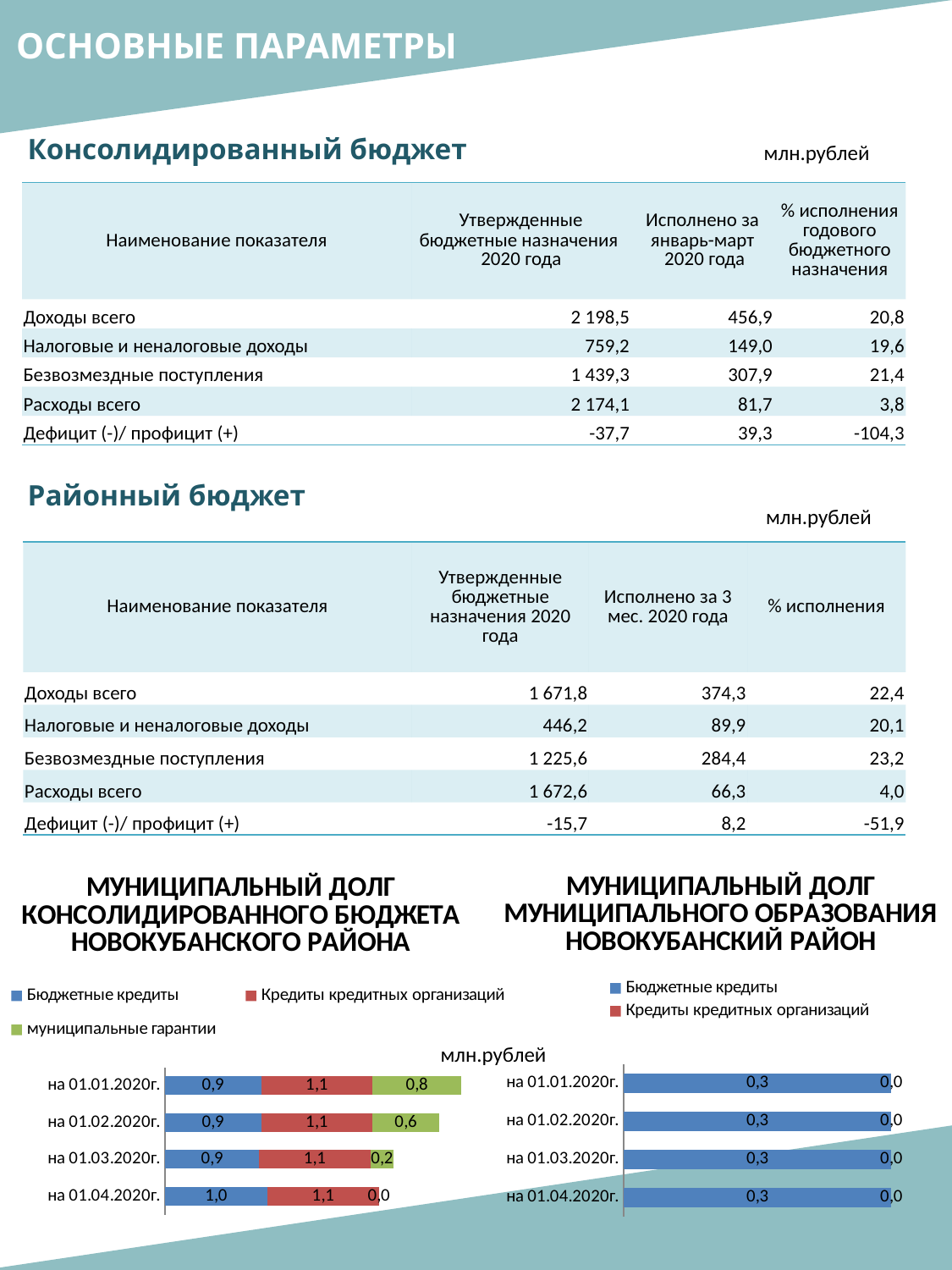
In the chart titled 'МУНИЦИПАЛЬНЫЙ ДОЛГ КОНСОЛИДИРОВАННОГО БЮДЖЕТА НОВОКУБАНСКОГО РАЙОНА', what is the total of the stacked bar for 01.01.2020? 2,8 In the chart titled 'МУНИЦИПАЛЬНЫЙ ДОЛГ КОНСОЛИДИРОВАННОГО БЮДЖЕТА НОВОКУБАНСКОГО РАЙОНА', what is the value of 'Кредиты кредитных организаций' on 01.03.2020? 1,1 How many series does the legend list in the chart titled 'МУНИЦИПАЛЬНЫЙ ДОЛГ КОНСОЛИДИРОВАННОГО БЮДЖЕТА НОВОКУБАНСКОГО РАЙОНА'? 3 In the chart titled 'МУНИЦИПАЛЬНЫЙ ДОЛГ КОНСОЛИДИРОВАННОГО БЮДЖЕТА НОВОКУБАНСКОГО РАЙОНА', what is the value of 'муниципальные гарантии' on 01.01.2020? 0,8 In the chart titled 'МУНИЦИПАЛЬНЫЙ ДОЛГ КОНСОЛИДИРОВАННОГО БЮДЖЕТА НОВОКУБАНСКОГО РАЙОНА', does the value of 'муниципальные гарантии' rise or fall from 01.01.2020 to 01.04.2020? fall In the chart titled 'МУНИЦИПАЛЬНЫЙ ДОЛГ КОНСОЛИДИРОВАННОГО БЮДЖЕТА НОВОКУБАНСКОГО РАЙОНА', what is the difference between 'муниципальные гарантии' on 01.01.2020 and on 01.03.2020? 0,6 In the chart titled 'МУНИЦИПАЛЬНЫЙ ДОЛГ КОНСОЛИДИРОВАННОГО БЮДЖЕТА НОВОКУБАНСКОГО РАЙОНА', on which date is the value of 'муниципальные гарантии' highest? на 01.01.2020г. In the chart titled 'МУНИЦИПАЛЬНЫЙ ДОЛГ КОНСОЛИДИРОВАННОГО БЮДЖЕТА НОВОКУБАНСКОГО РАЙОНА', what is the total of the stacked bar for 01.04.2020? 2,1 What kind of chart is the chart titled 'МУНИЦИПАЛЬНЫЙ ДОЛГ МУНИЦИПАЛЬНОГО ОБРАЗОВАНИЯ НОВОКУБАНСКИЙ РАЙОН'? Stacked bar chart In the chart titled 'МУНИЦИПАЛЬНЫЙ ДОЛГ КОНСОЛИДИРОВАННОГО БЮДЖЕТА НОВОКУБАНСКОГО РАЙОНА', what is the value of 'Бюджетные кредиты' on 01.04.2020? 1,0 How many dates (categories) are shown in the chart titled 'МУНИЦИПАЛЬНЫЙ ДОЛГ МУНИЦИПАЛЬНОГО ОБРАЗОВАНИЯ НОВОКУБАНСКИЙ РАЙОН'? 4 In the chart titled 'МУНИЦИПАЛЬНЫЙ ДОЛГ МУНИЦИПАЛЬНОГО ОБРАЗОВАНИЯ НОВОКУБАНСКИЙ РАЙОН', what is the value of 'Бюджетные кредиты' on 01.02.2020? 0,3